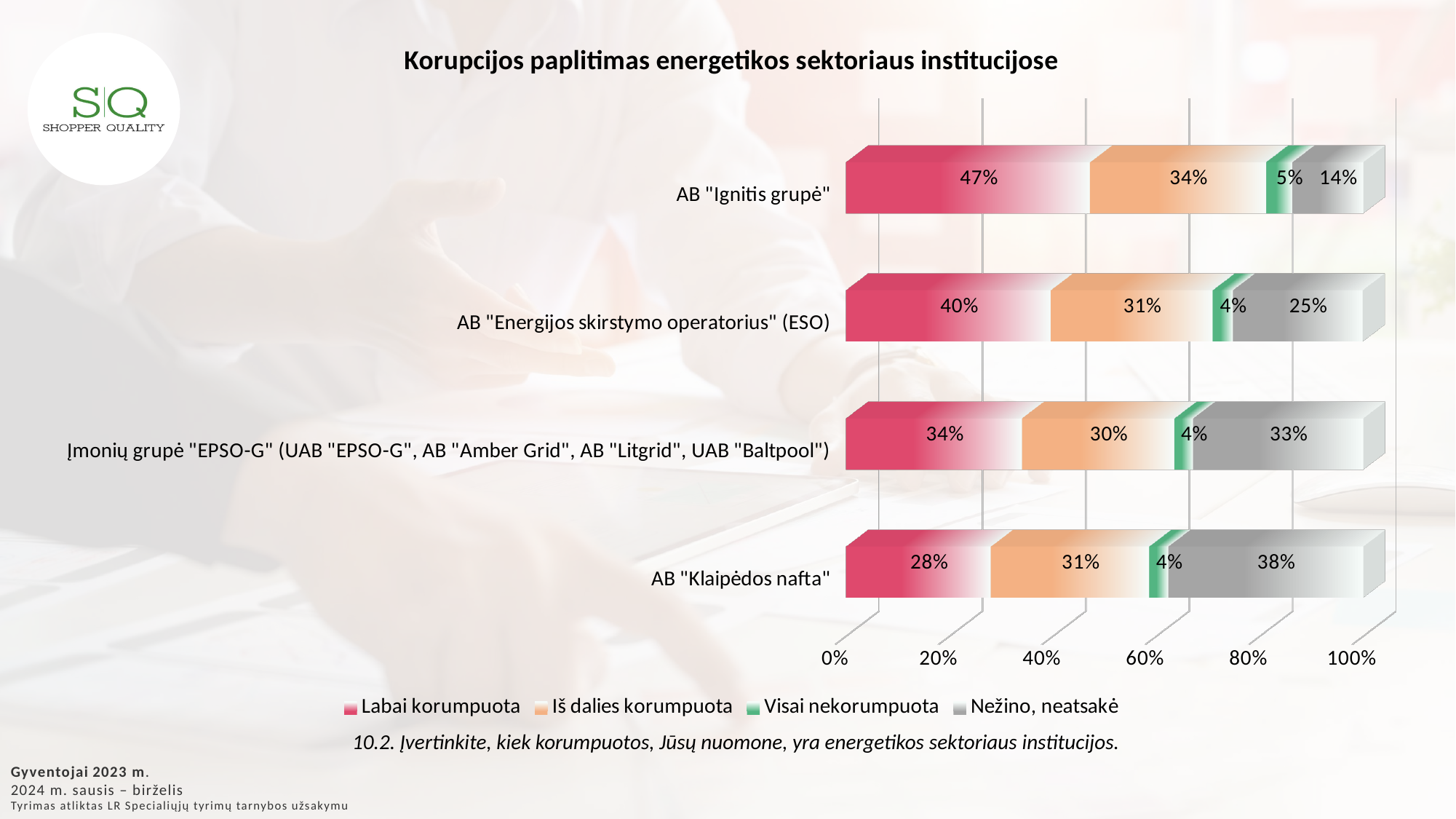
What is the "Nežino, neatsakė" value for AB "Klaipėdos nafta"? 38% What is the difference in percentage points between the "Labai korumpuota" values for AB "Ignitis grupė" and AB "Klaipėdos nafta"? 19 percentage points Which institution has the highest "Labai korumpuota" share? AB "Ignitis grupė" What colour represents "Visai nekorumpuota" in the legend? Green Which has a larger "Nežino, neatsakė" share: AB "Energijos skirstymo operatorius" (ESO) or Įmonių grupė "EPSO-G"? Įmonių grupė "EPSO-G" What is the "Visai nekorumpuota" value for AB "Ignitis grupė"? 5% How many institutions are shown in the chart? 4 Which institution has the lowest "Labai korumpuota" share? AB "Klaipėdos nafta" What type of chart is shown on the slide? Stacked bar chart How many series does the legend list? 4 What percentage of respondents rated AB "Ignitis grupė" as "Labai korumpuota"? 47% Which institution has the highest "Nežino, neatsakė" share? AB "Klaipėdos nafta"